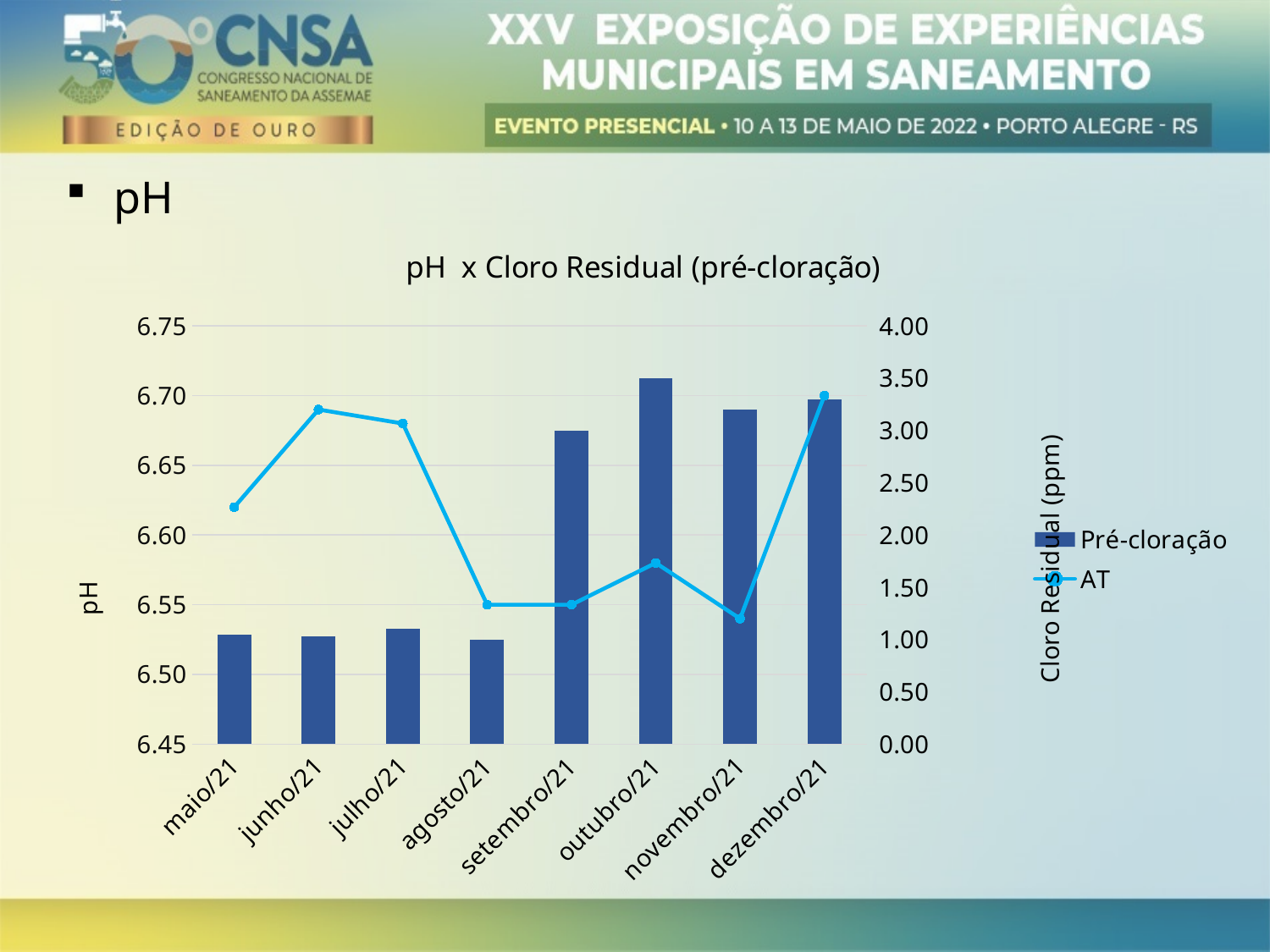
How many months are shown on the x axis? 8 What kind of chart is shown on the slide? Combination bar and line chart Which is larger, the AT value for junho/21 or for novembro/21? junho/21 Is the Pré-cloração value for maio/21 greater or less than 6.55? less Which month has the highest Pré-cloração bar? outubro/21 What is the label of the right-hand vertical axis? Cloro Residual (ppm) How many series does the legend list? 2 What is the title of the chart? pH x Cloro Residual (pré-cloração) Is the AT value for junho/21 greater or less than 3.00? greater Which is larger, the Pré-cloração value for outubro/21 or for maio/21? outubro/21